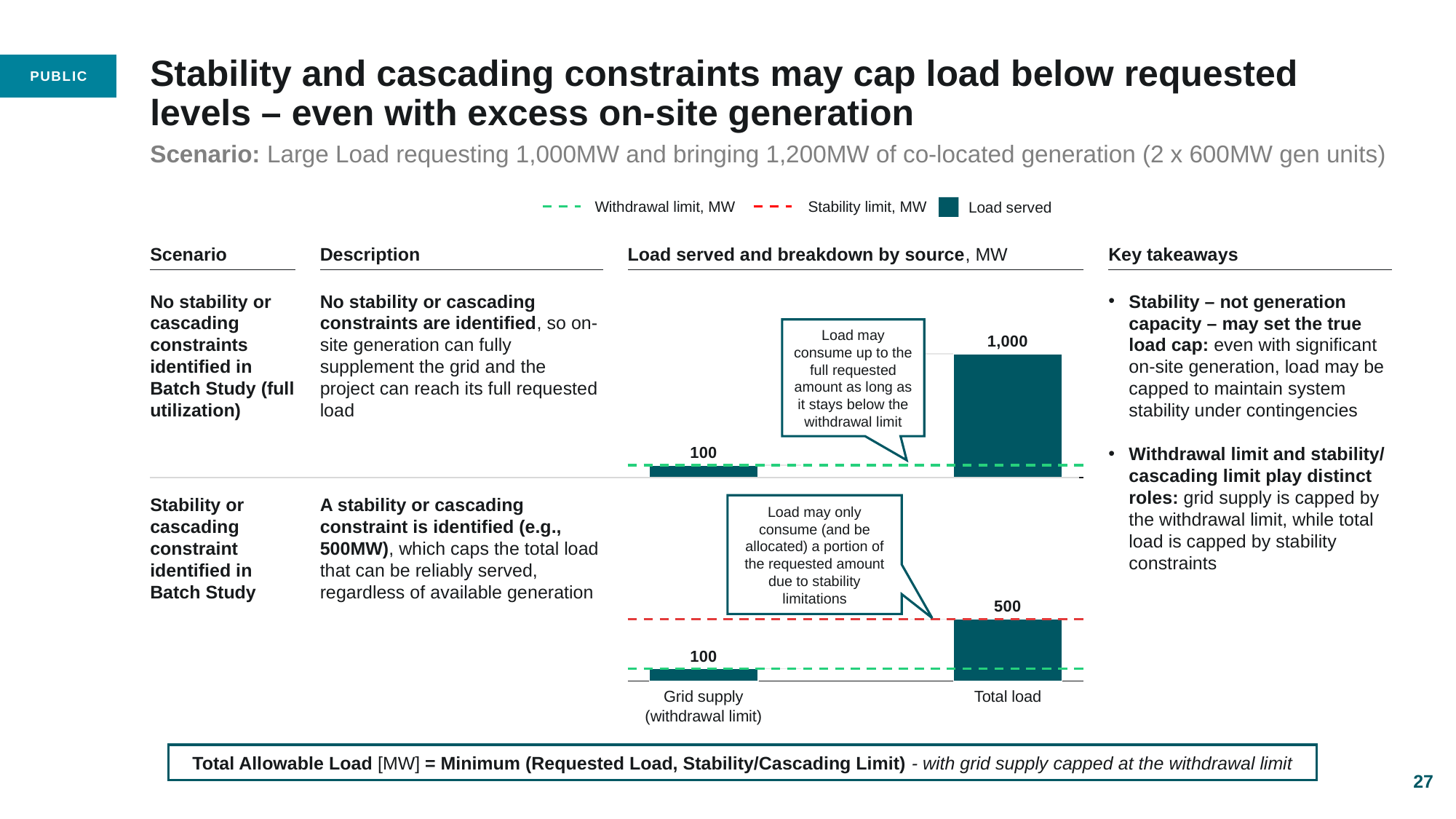
In the bottom chart, which bar is higher: Grid supply (withdrawal limit) or Total load? Total load How many entries does the shared legend above the charts list? 3 What type of chart is used to show load served and breakdown by source? Bar chart In the bottom chart (stability or cascading constraint identified scenario), what is the value for Grid supply (withdrawal limit)? 100 How many bars are plotted in the bottom chart? 2 In the top chart, what is the difference between Total load and Grid supply (withdrawal limit)? 900 In the top chart (no stability or cascading constraints scenario), what is the value for Grid supply (withdrawal limit)? 100 What is the difference between the Total load in the top chart and the Total load in the bottom chart? 500 In the bottom chart (stability or cascading constraint identified scenario), what is the value for Total load? 500 In the bottom chart, what is the difference between Total load and Grid supply (withdrawal limit)? 400 In the top chart (no stability or cascading constraints scenario), what is the value for Total load? 1,000 In the top chart, which category has the highest value? Total load